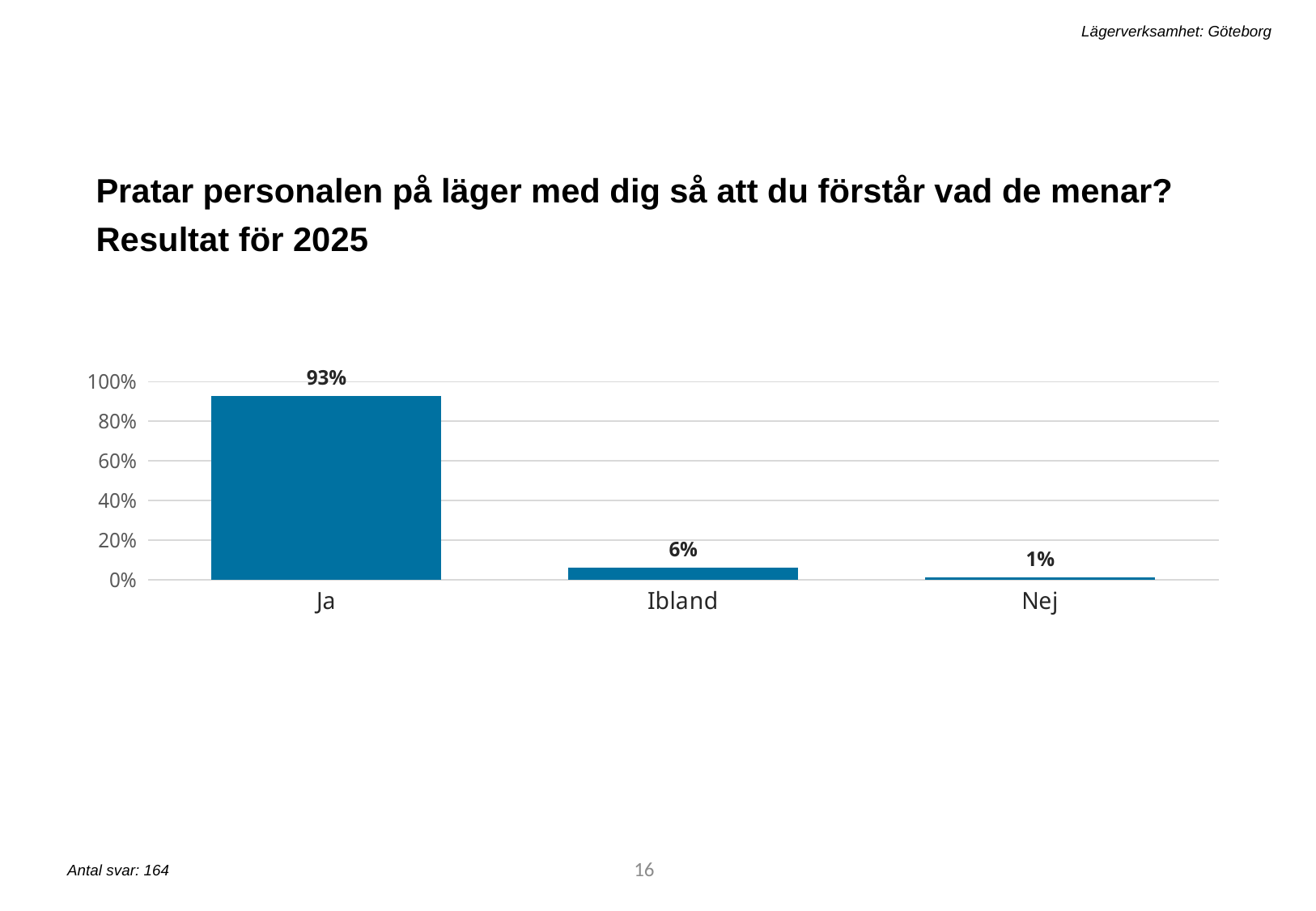
How many categories are shown on the x axis? 3 What is the value for Nej? 1% Which category has the lowest value? Nej What is the difference between the values for Ja and Ibland? 87% What is the difference between the values for Ibland and Nej? 5% Do the values rise or fall from left to right along the x axis? fall Which is larger, the value for Ibland or the value for Nej? Ibland What is the value for Ja? 93% What is the value for Ibland? 6% What kind of chart is shown on the slide? bar chart Is the value for Ja greater or less than 80%? greater Which category has the highest value? Ja